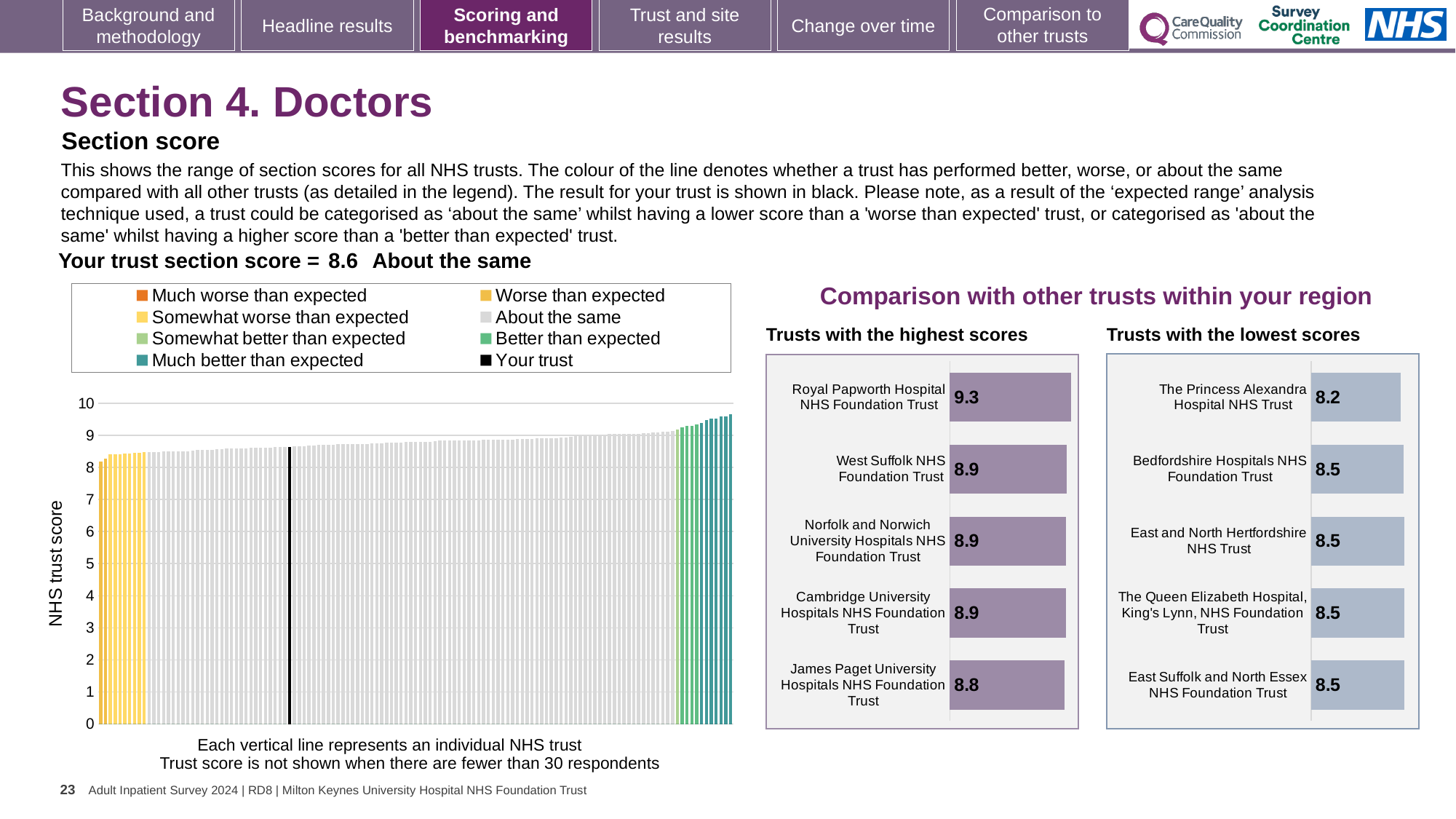
In the 'Trusts with the highest scores' chart, what is the difference between the scores of Royal Papworth Hospital NHS Foundation Trust and James Paget University Hospitals NHS Foundation Trust? 0.5 Which has the higher score: West Suffolk NHS Foundation Trust in the highest scores chart or The Princess Alexandra Hospital NHS Trust in the lowest scores chart? West Suffolk NHS Foundation Trust How many trusts are shown in the 'Trusts with the highest scores' chart? 5 What kind of chart is the large 'NHS trust score' chart on the left of the slide? Bar chart In the 'Trusts with the highest scores' chart, which trust has the highest score? Royal Papworth Hospital NHS Foundation Trust In the 'Trusts with the highest scores' chart, what is the score for Royal Papworth Hospital NHS Foundation Trust? 9.3 In the large 'NHS trust score' chart, is the value for the black 'Your trust' line greater or less than 8? greater In the 'Trusts with the lowest scores' chart, which trust has the lowest score? The Princess Alexandra Hospital NHS Trust In the 'Trusts with the highest scores' chart, what is the score for James Paget University Hospitals NHS Foundation Trust? 8.8 In the 'Trusts with the lowest scores' chart, how much higher is the score of Bedfordshire Hospitals NHS Foundation Trust than that of The Princess Alexandra Hospital NHS Trust? 0.3 In the 'Trusts with the lowest scores' chart, what is the score for Bedfordshire Hospitals NHS Foundation Trust? 8.5 In the 'Trusts with the lowest scores' chart, what is the score for The Princess Alexandra Hospital NHS Trust? 8.2